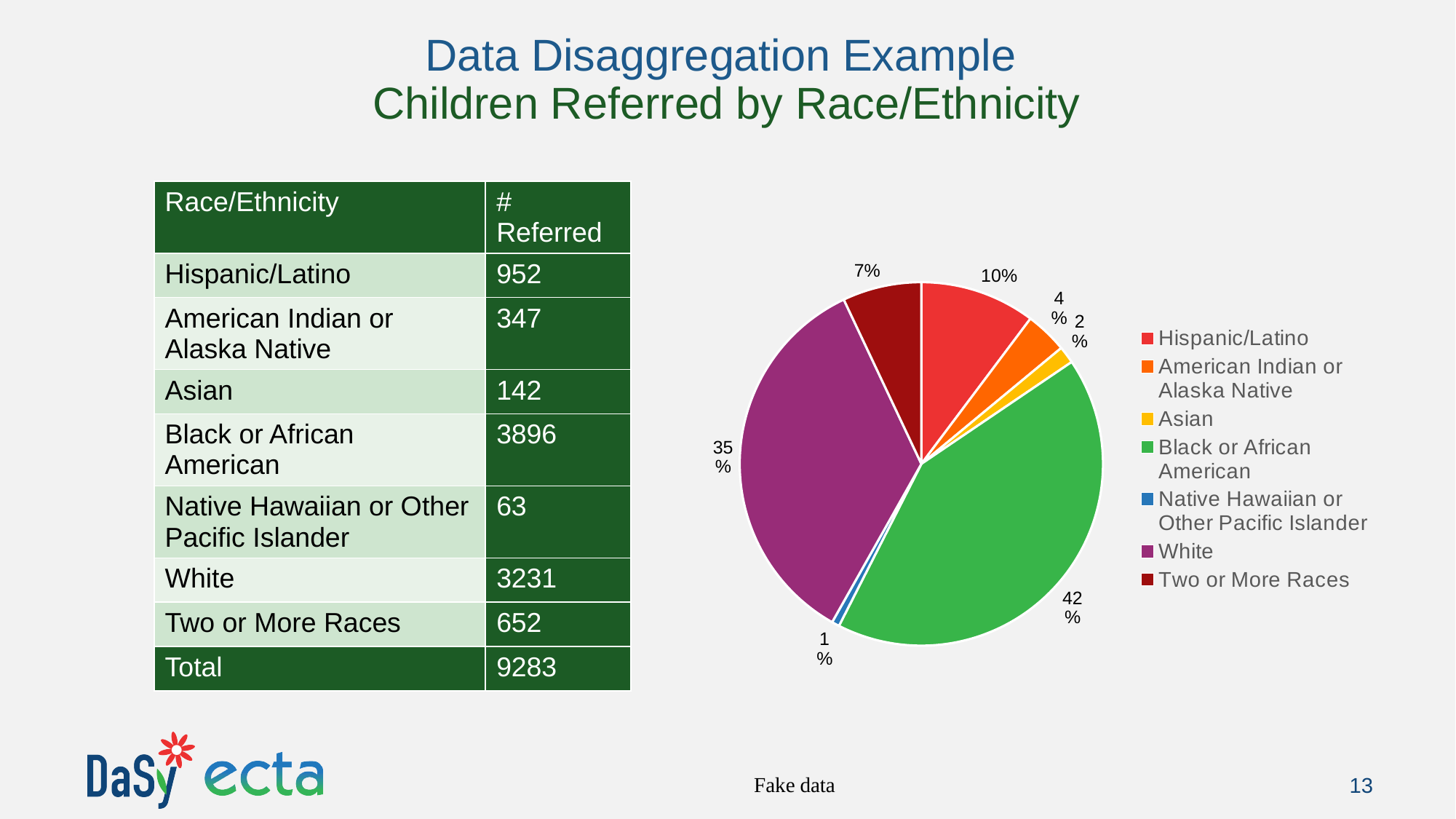
In the pie chart, what share of children referred is Two or More Races? 7% Which category has the smallest slice in the pie chart? Native Hawaiian or Other Pacific Islander Which category has the largest slice in the pie chart? Black or African American In the pie chart, what share of children referred is Hispanic/Latino? 10% What kind of chart is shown on the slide? pie chart What is the difference in percentage points between the Black or African American slice and the White slice in the pie chart? 7 How many categories does the pie chart legend list? 7 In the pie chart, which slice is larger: White or Hispanic/Latino? White What colour is the Black or African American slice in the pie chart? green In the pie chart, what share of children referred is White? 35%